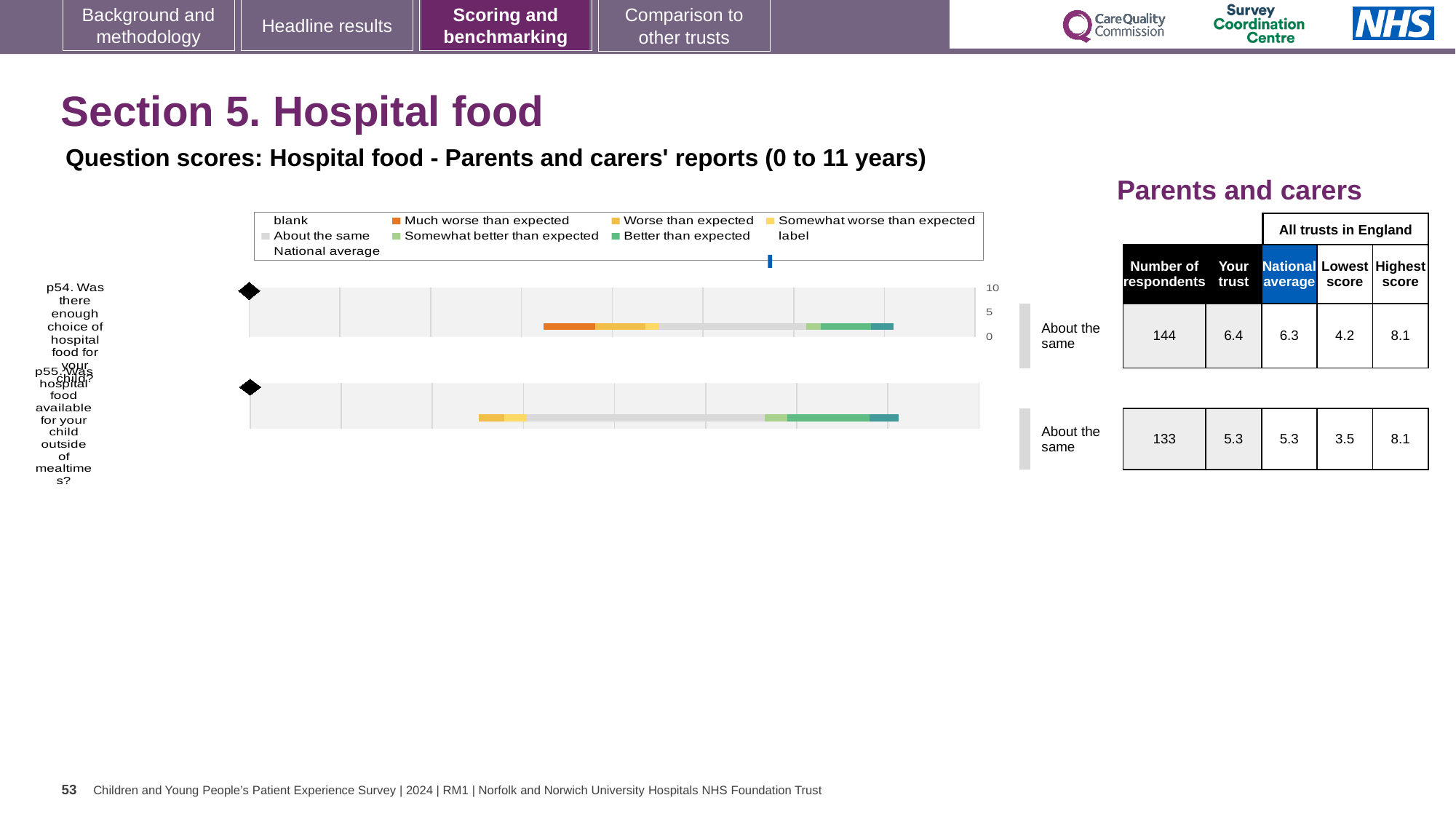
What is the 'Your trust' score for p54 (enough choice of hospital food for your child)? 6.4 What is the lowest score among all trusts in England for p55? 3.5 What kind of chart is used to show the question scores for hospital food? bar chart What is the national average score for p55 (hospital food available outside of mealtimes)? 5.3 Which legend entry is shown in orange? Much worse than expected How many more respondents answered p54 than p55? 11 What is the difference between the 'Your trust' score and the national average for p54? 0.1 How many questions (categories) are plotted in the hospital food chart? 2 Which question has the higher 'Your trust' score, p54 or p55? p54 What benchmark category is given for p55? About the same How many respondents answered p54? 144 What is the highest score among all trusts in England for p54? 8.1